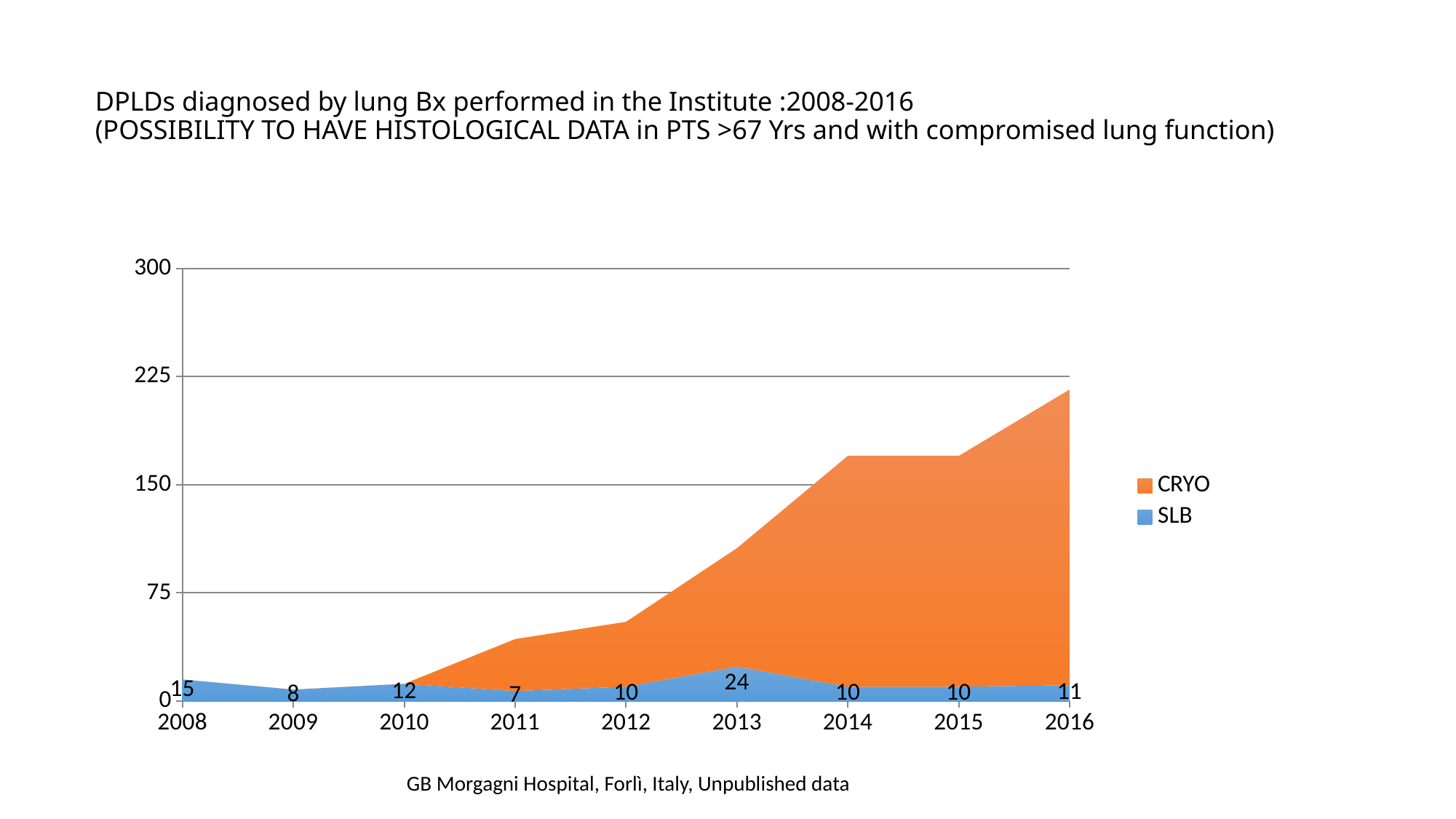
How many series does the legend list? 2 What is the SLB value for 2008? 15 What is the SLB value for 2013? 24 In which year is the SLB value highest? 2013 In which year is the SLB value lowest? 2011 Is the top of the stacked area in 2012 greater or less than 75? less What is the SLB value for 2016? 11 How many years are shown on the x axis? 9 What is the difference between the SLB value in 2013 and the SLB value in 2011? 17 Which year has a larger SLB value, 2008 or 2009? 2008 What kind of chart is shown on the slide? Stacked area chart Is the top of the stacked area in 2016 greater or less than 150? greater